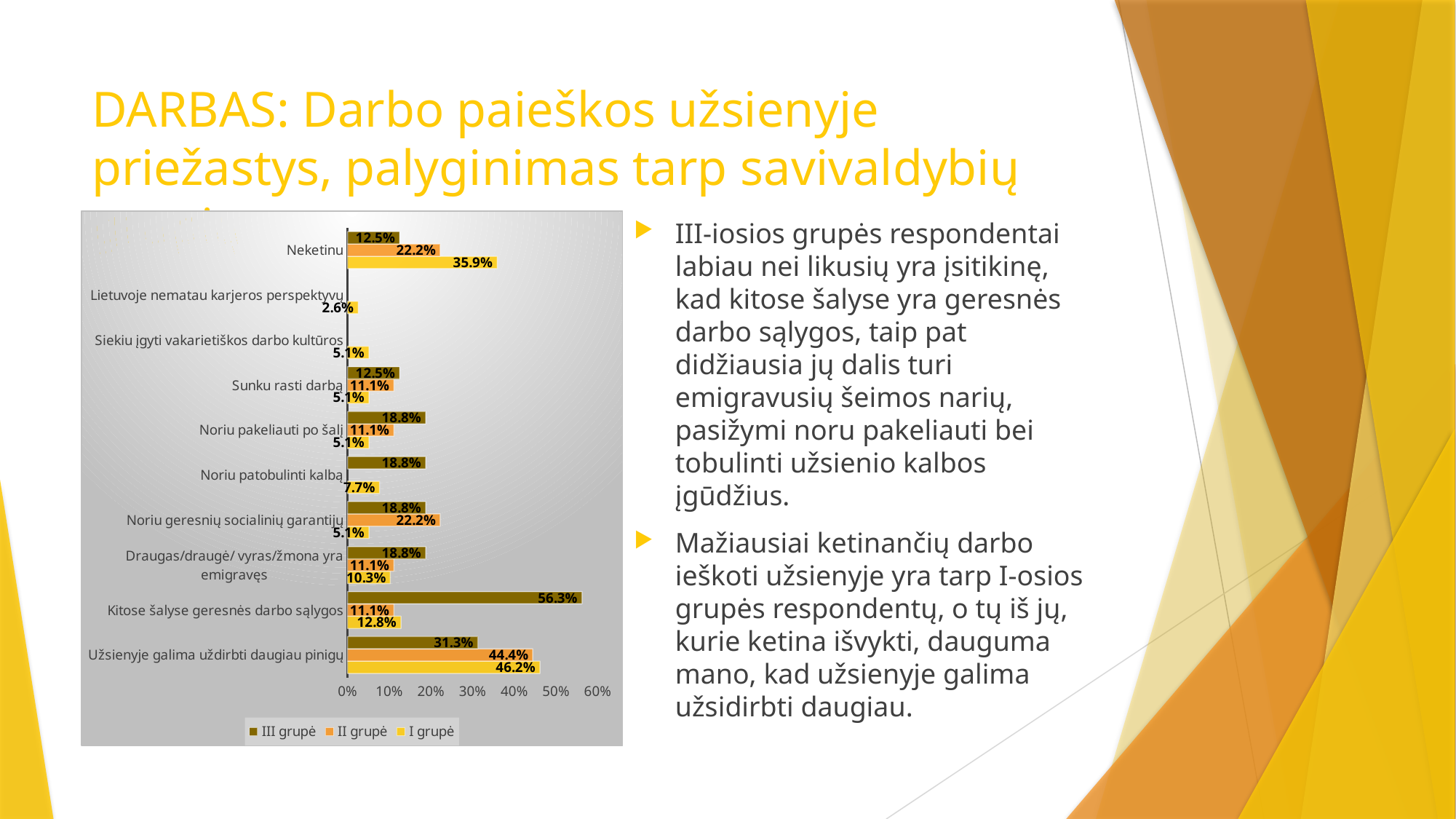
Which series is shown in yellow in the legend? I grupė What type of chart is shown on the slide? bar chart How many series does the legend list? 3 What is the value for III grupė in the category 'Kitose šalyse geresnės darbo sąlygos'? 56.3% What is the value for II grupė in the category 'Užsienyje galima uždirbti daugiau pinigų'? 44.4% For 'Noriu geresnių socialinių garantijų', which is larger: the II grupė value or the III grupė value? II grupė What is the value for I grupė in the category 'Neketinu'? 35.9% Which category has the highest value for I grupė? Užsienyje galima uždirbti daugiau pinigų How many categories are shown on the chart? 10 Is the III grupė value for 'Kitose šalyse geresnės darbo sąlygos' greater or less than 50%? greater What is the difference between the I grupė and II grupė values for 'Neketinu'? 13.7% Which category has the highest value for III grupė? Kitose šalyse geresnės darbo sąlygos